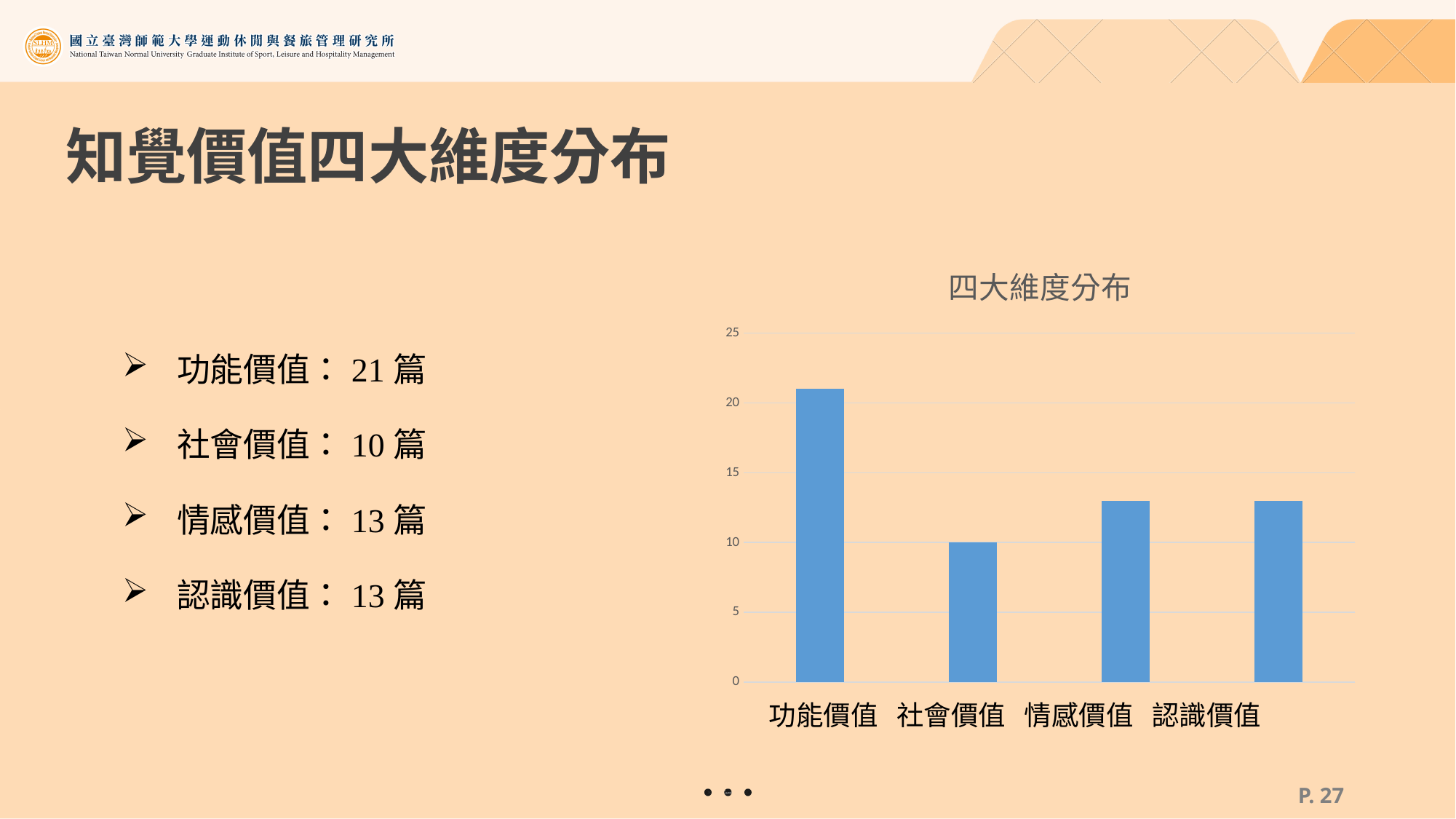
What is the value for 社會價值? 10 Which category has the lowest value in the chart? 社會價值 Is the value for 功能價值 greater or less than 20? greater What is the value for 情感價值? 13 What is the title of the chart? 四大維度分布 Which category has the highest value in the chart? 功能價值 Which is larger, the value for 功能價值 or the value for 認識價值? 功能價值 How many categories are shown on the x axis of the chart? 4 What is the value for 功能價值? 21 What is the difference between the values for 功能價值 and 社會價值? 11 Is the value for 情感價值 greater or less than 15? less What kind of chart is shown on the slide? bar chart